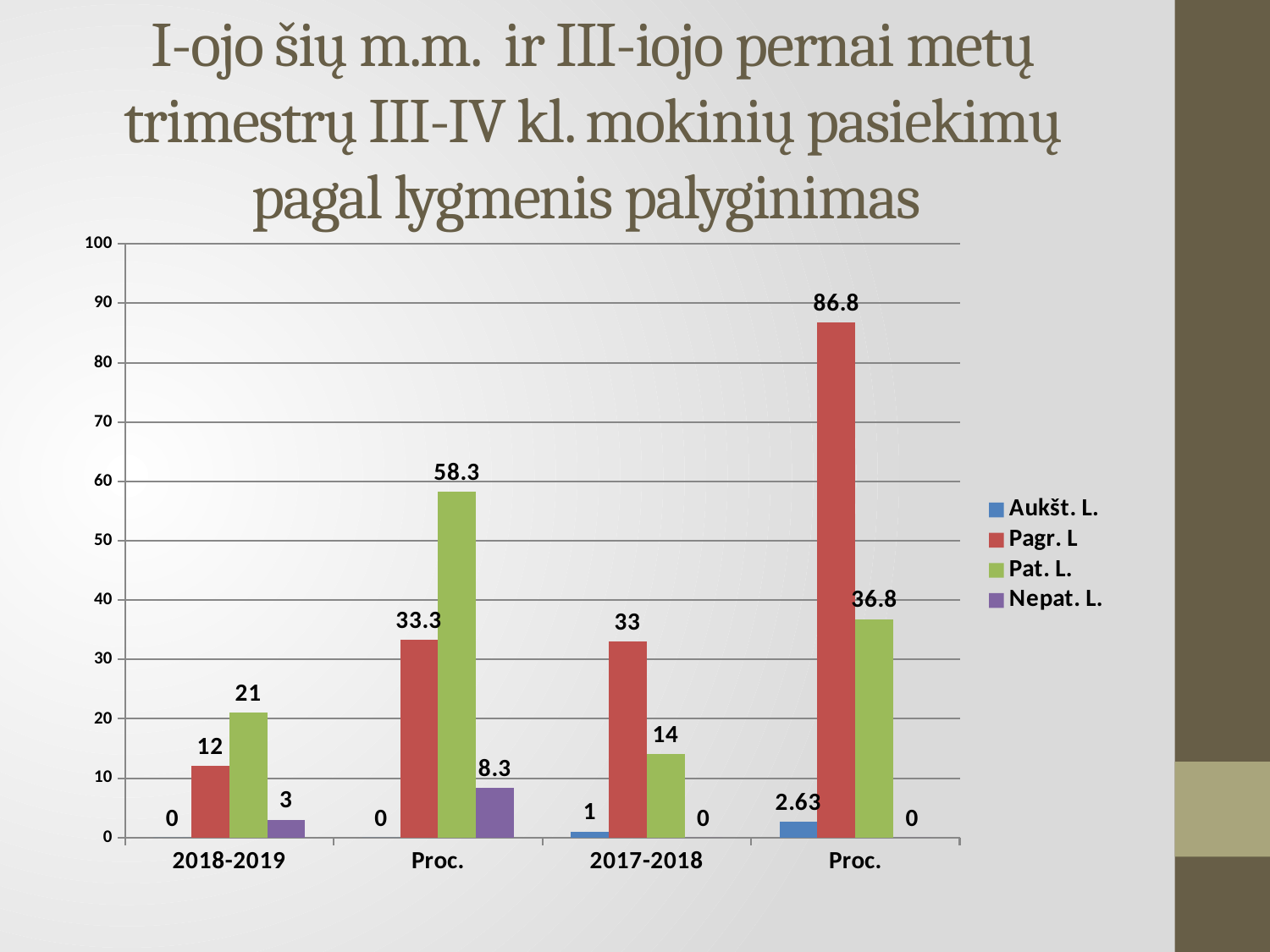
What is the value of Pagr. L in the fourth category (the Proc. group on the far right)? 86.8 What kind of chart is shown on the slide? Bar chart What is the value of Nepat. L. in the second category (the Proc. group following 2018-2019)? 8.3 What is the value of Pat. L. for 2018-2019? 21 What colour are the Pagr. L bars? Red How many series does the legend list? 4 Which series has the lowest value for 2017-2018? Nepat. L. What is the value of Aukšt. L. for 2017-2018? 1 Which series has the highest value in the far-right Proc. group? Pagr. L What is the difference between Pat. L. and Pagr. L in the second category (the Proc. group following 2018-2019)? 25 How many categories are shown on the x axis? 4 Which is larger for 2018-2019: Pagr. L or Pat. L.? Pat. L.